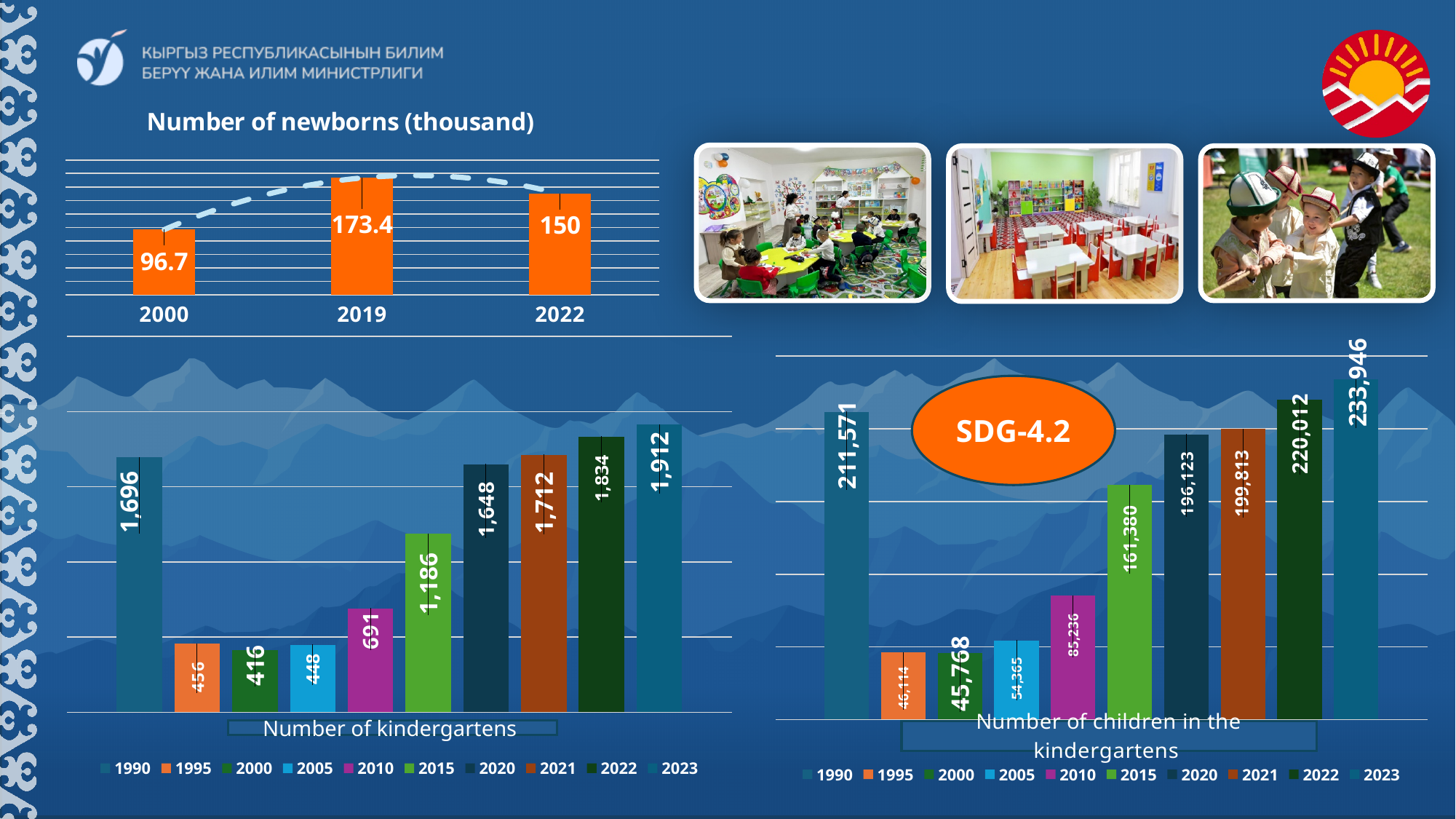
In the 'Number of newborns (thousand)' chart, what is the difference between the 2019 and 2022 values? 23.4 What type of chart is the 'Number of children in the kindergartens' chart? Bar chart In the 'Number of kindergartens' chart, what is the value for 2010? 691 In the 'Number of kindergartens' chart, which year has the lowest value? 2000 In the 'Number of kindergartens' chart, which year has the highest value? 2023 How many entries does the legend of the 'Number of kindergartens' chart list? 10 How many bars are in the 'Number of newborns (thousand)' chart? 3 In the 'Number of children in the kindergartens' chart, what is the value for 2015? 161,380 In the 'Number of newborns (thousand)' chart, which year has the lowest value? 2000 In the 'Number of kindergartens' chart, what is the difference between the 2023 and 2022 values? 78 In the 'Number of newborns (thousand)' chart, what is the value for 2019? 173.4 In the 'Number of children in the kindergartens' chart, which is larger, the value for 1990 or the value for 2022? 2022